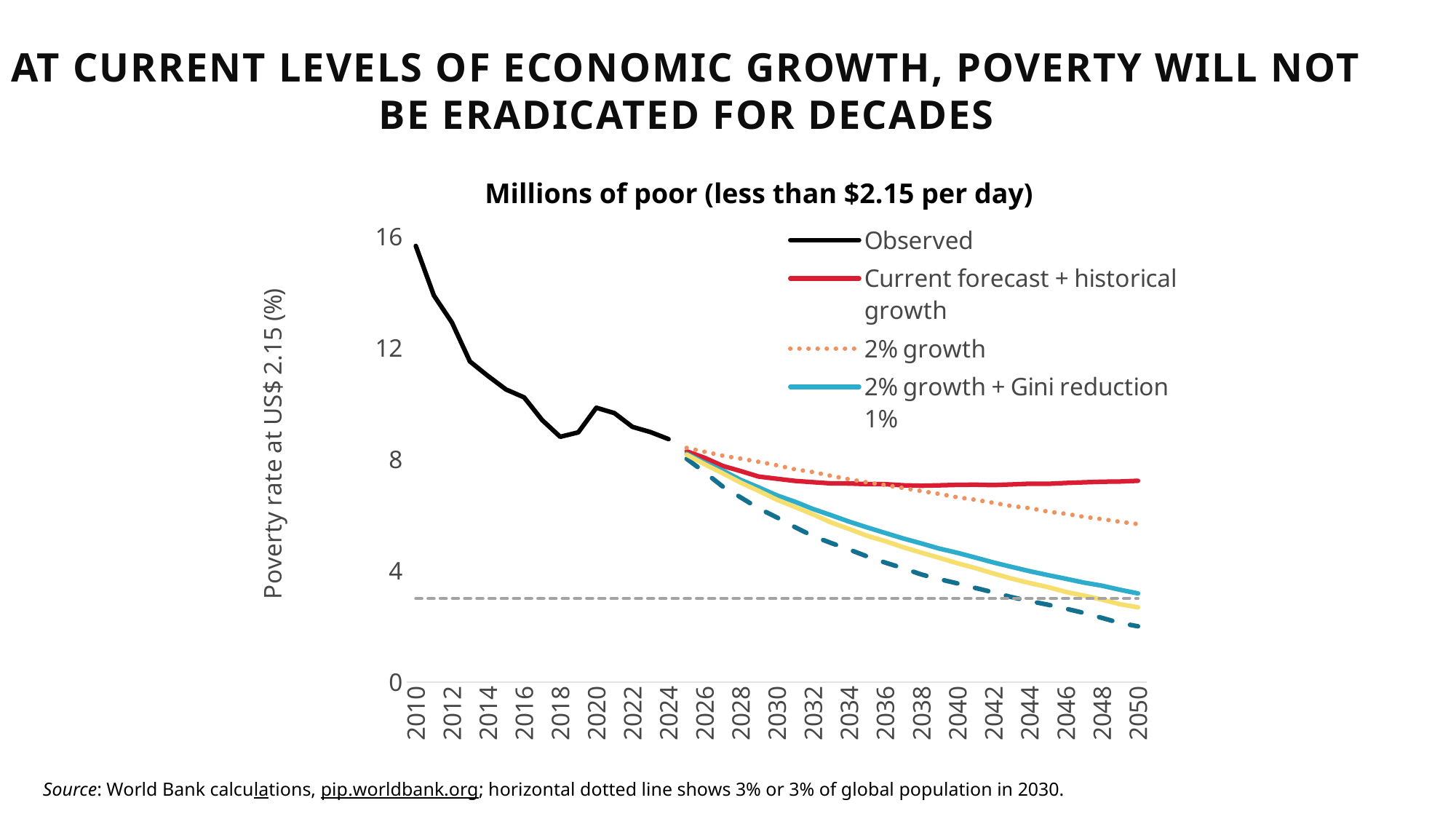
What kind of chart is shown on the slide? line chart What is the title of the chart? Millions of poor (less than $2.15 per day) Is the value of the 2% growth + Gini reduction 1% line in 2050 greater or less than 4? less Is the Observed value in 2010 greater or less than 12? greater How many series does the legend list? 4 What is the label on the vertical axis? Poverty rate at US$ 2.15 (%) Is the Observed value in 2024 greater or less than 12? less In 2050, which is higher: the Current forecast + historical growth line or the 2% growth line? Current forecast + historical growth Does the Observed line rise or fall between 2010 and 2024? fall Which legend series has the highest value in 2050? Current forecast + historical growth